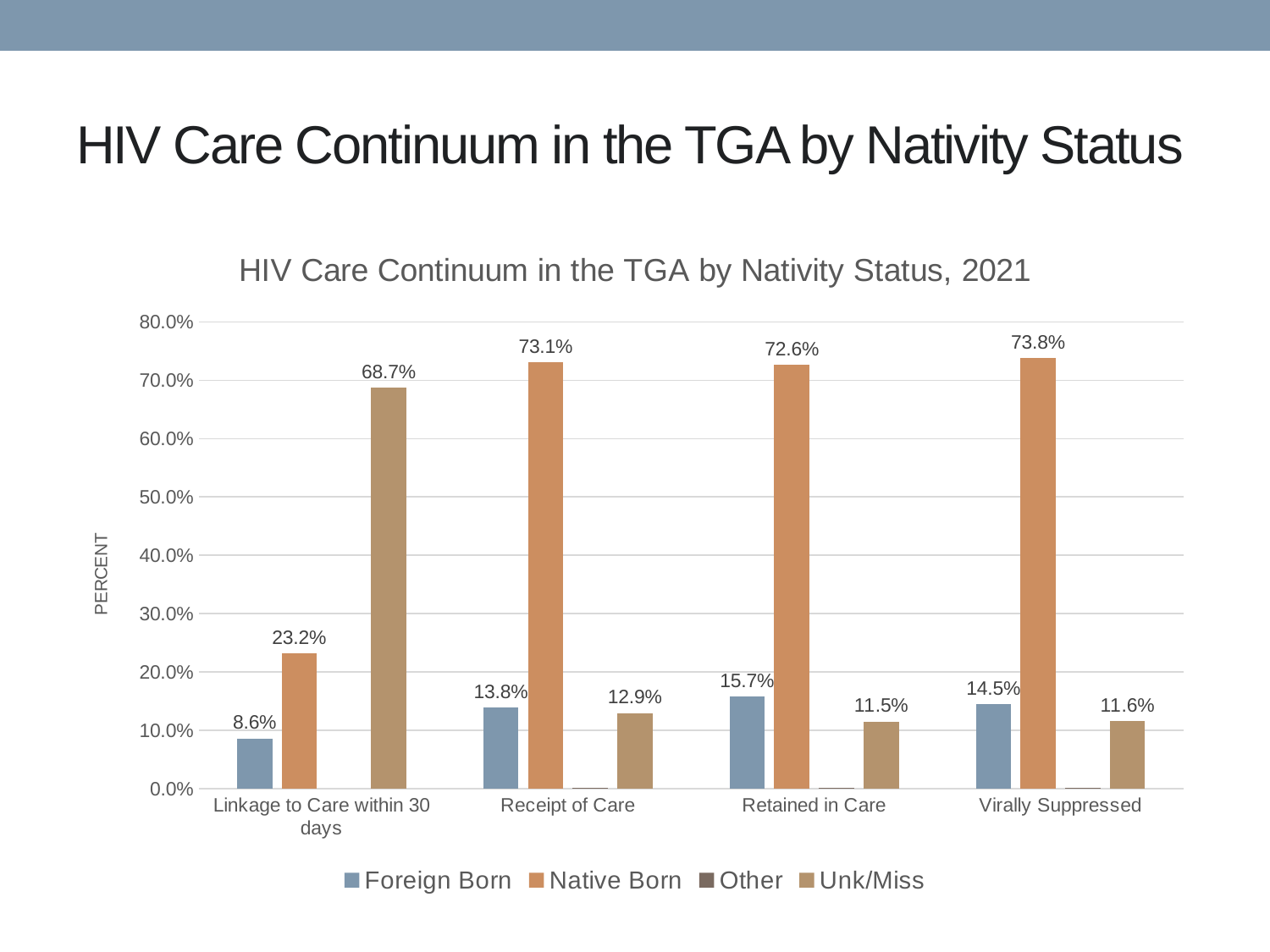
What is the Native Born value for Receipt of Care? 73.1% How many categories are shown on the x axis? 4 Which category has the lowest Foreign Born value? Linkage to Care within 30 days Which category has the highest Native Born value? Virally Suppressed What is the Unk/Miss value for Linkage to Care within 30 days? 68.7% Is the Unk/Miss value for Retained in Care greater or less than 20.0%? less What is the label of the y axis? PERCENT Which is larger for Linkage to Care within 30 days: the Native Born value or the Unk/Miss value? Unk/Miss What kind of chart is shown? bar chart What is the Foreign Born value for Retained in Care? 15.7% What is the difference between the Native Born and Foreign Born values for Virally Suppressed? 59.3% How many series does the legend list? 4